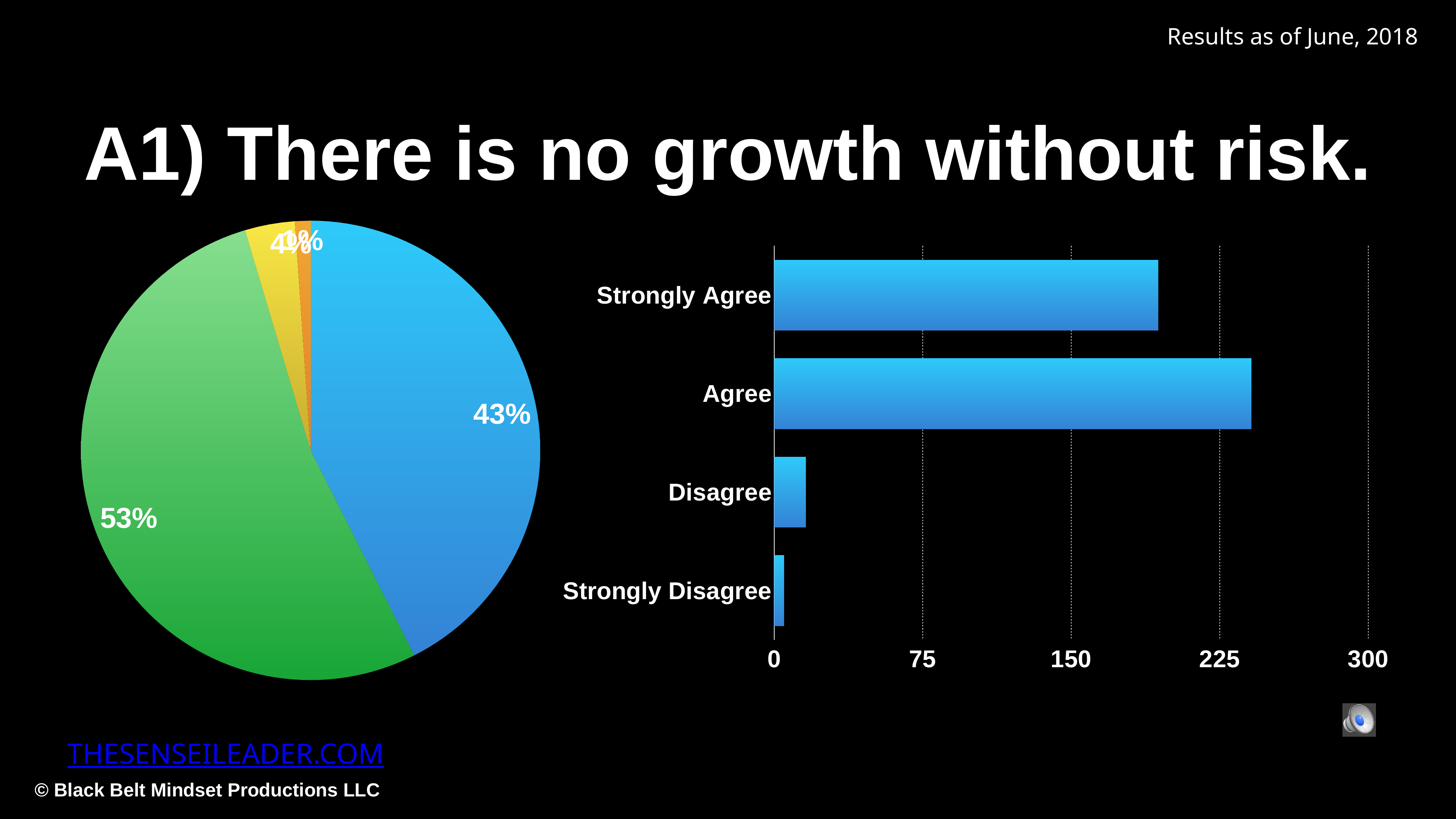
In the bar chart on the right, which category has the highest value? Agree In the bar chart on the right, is the value for Strongly Agree greater or less than 150? greater In the bar chart on the right, how many categories are shown? 4 In the bar chart on the right, which is larger: Strongly Agree or Agree? Agree In the bar chart on the right, which category has the lowest value? Strongly Disagree What kind of chart is the chart on the left side of the slide? pie chart In the bar chart on the right, is the value for Agree greater or less than 225? greater In the bar chart on the right, is the value for Disagree greater or less than 75? less In the pie chart on the left, what percentage is shown on the largest slice? 53% What kind of chart is the chart on the right side of the slide? bar chart In the bar chart on the right, which is larger: Disagree or Strongly Disagree? Disagree In the pie chart on the left, what percentage is shown on the blue slice? 43%